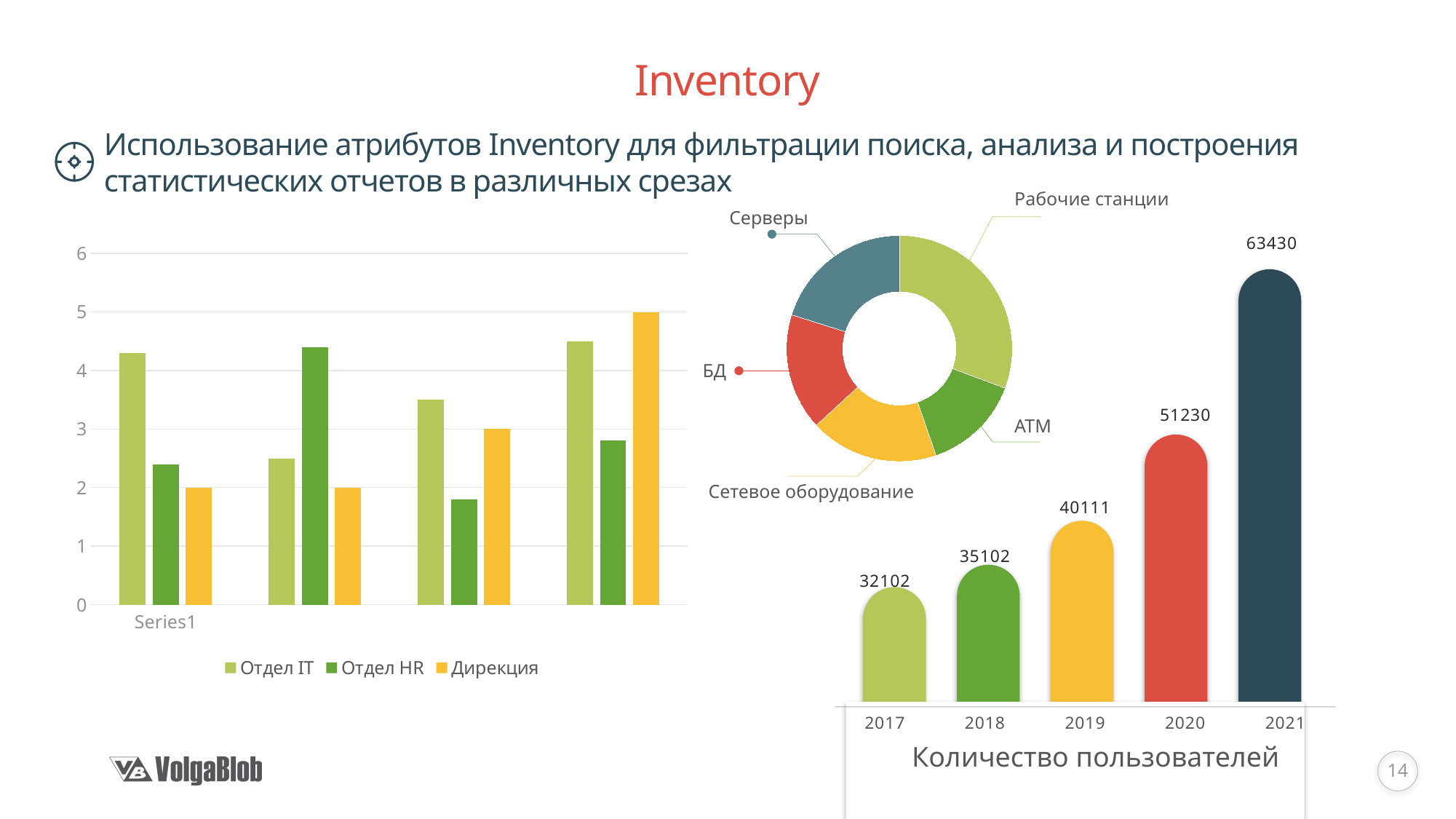
In the 'Количество пользователей' chart, which is larger, the value for 2018 or the value for 2019? 2019 In the bar chart on the left of the slide, how many series does the legend list? 3 In the donut chart in the middle of the slide, which category has the largest slice? Рабочие станции In the 'Количество пользователей' chart, what is the difference between the values for 2021 and 2020? 12200 In the donut chart in the middle of the slide, how many categories are shown? 5 In the 'Количество пользователей' chart, which year has the lowest value? 2017 In the 'Количество пользователей' chart, do the values rise or fall from 2017 to 2021? rise What kind of chart is shown on the left of the slide? bar chart In the 'Количество пользователей' chart, how many years are shown on the x axis? 5 In the 'Количество пользователей' chart, what is the value for 2019? 40111 In the bar chart on the left of the slide, is the value for Отдел IT in the first group (Series1) greater or less than 4? greater In the 'Количество пользователей' chart, which year has the highest value? 2021